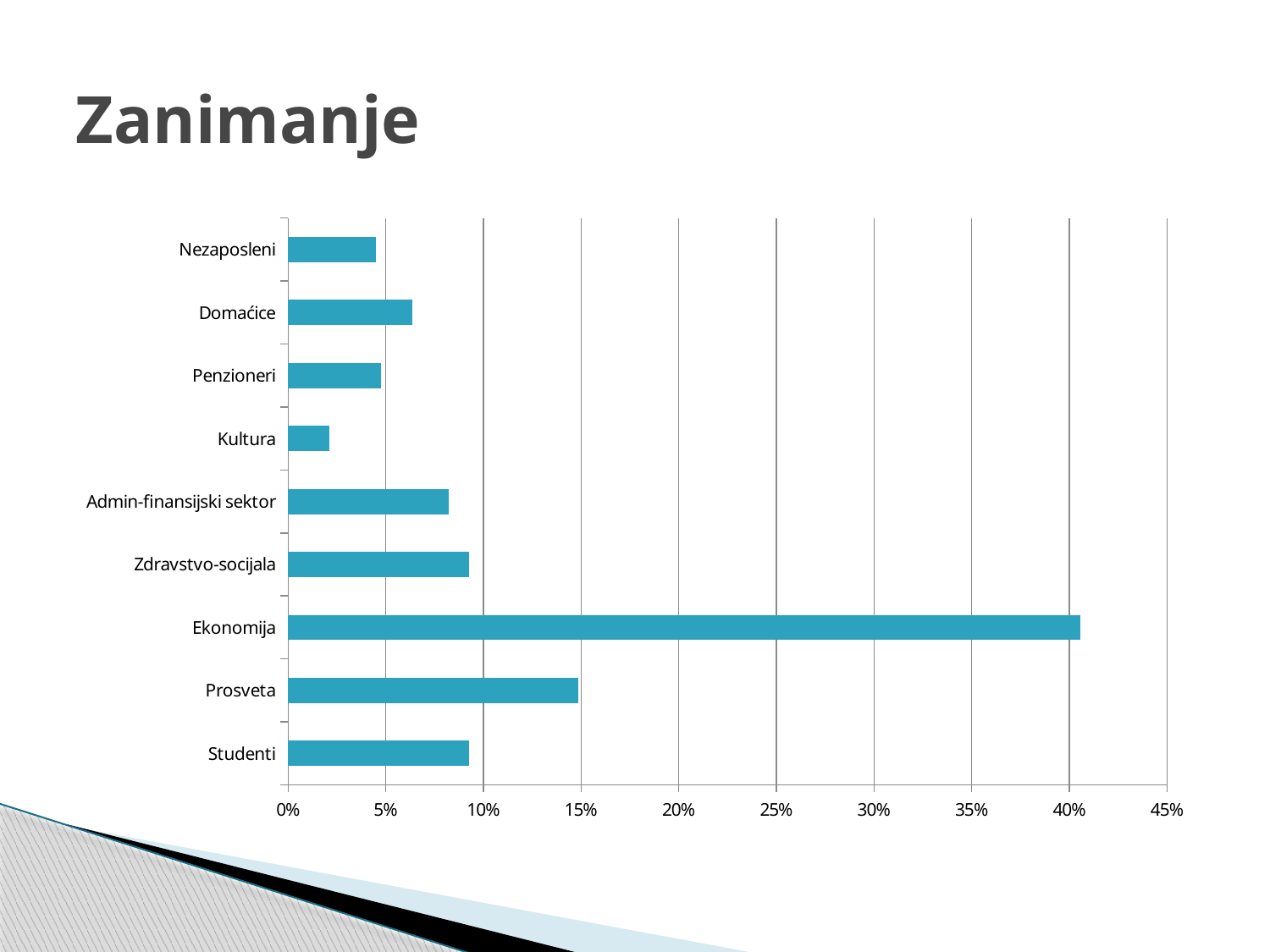
Is the value for Kultura greater or less than 5%? less Which has a larger value, Domaćice or Nezaposleni? Domaćice Is the value for Domaćice greater or less than 5%? greater Is the value for Ekonomija greater or less than 35%? greater How many categories are plotted in the chart? 9 Which category has the lowest value? Kultura What kind of chart is shown on the slide? bar chart What is the title of the slide containing the chart? Zanimanje Which has a larger value, Prosveta or Studenti? Prosveta Which category has the highest value? Ekonomija